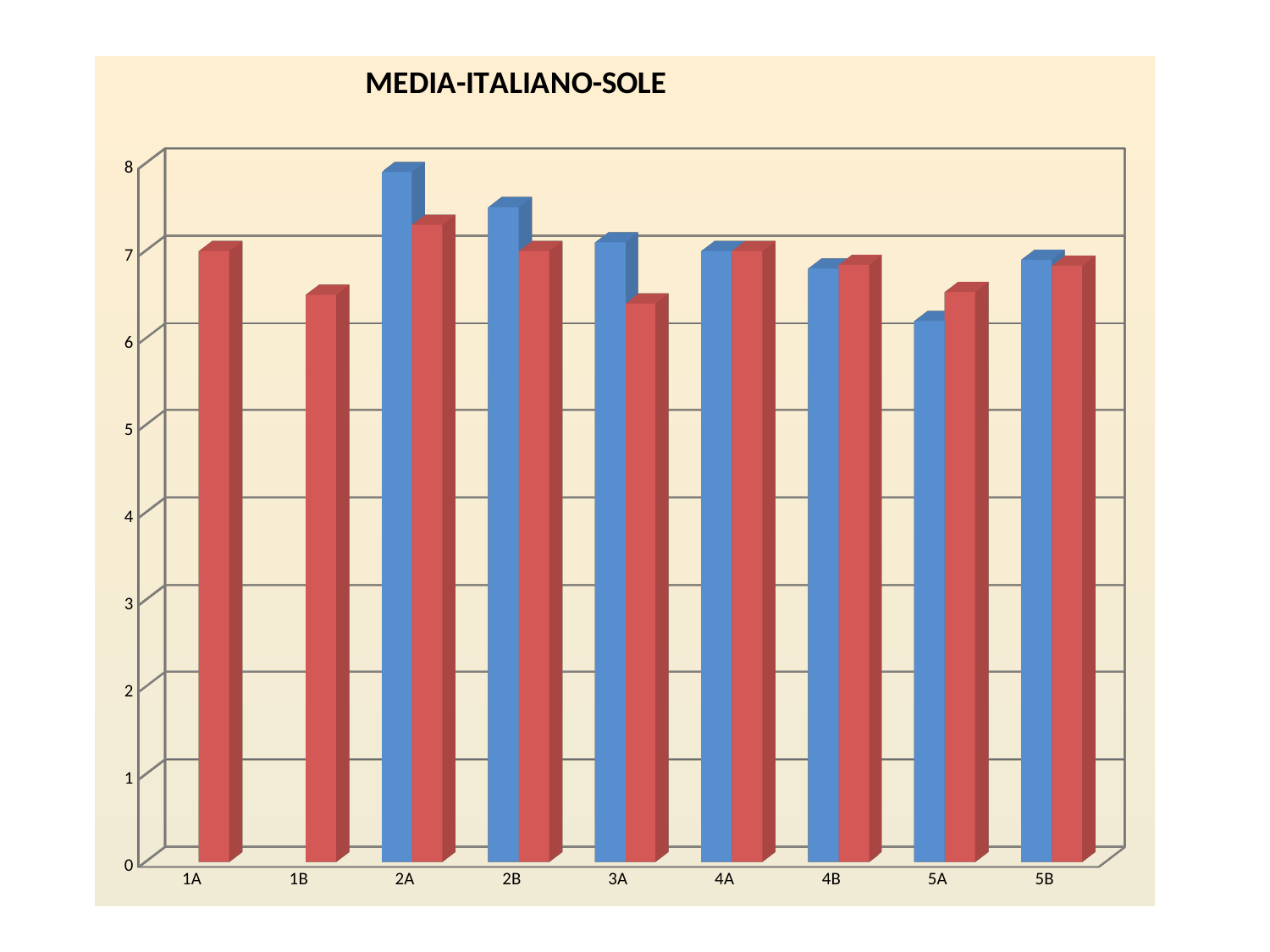
Which category has the tallest blue bar? 2A How many categories are shown on the x axis? 9 Is the blue bar for 2A greater or less than 7? greater What kind of chart is shown on the slide? bar chart What is the title of the chart? MEDIA-ITALIANO-SOLE For category 3A, which bar is taller, the blue one or the red one? blue Which category has the shortest blue bar? 5A Which category has the tallest red bar? 2A For category 5A, which bar is taller, the blue one or the red one? red Is the blue bar for 5A greater or less than 7? less Is the red bar for 3A greater or less than 7? less